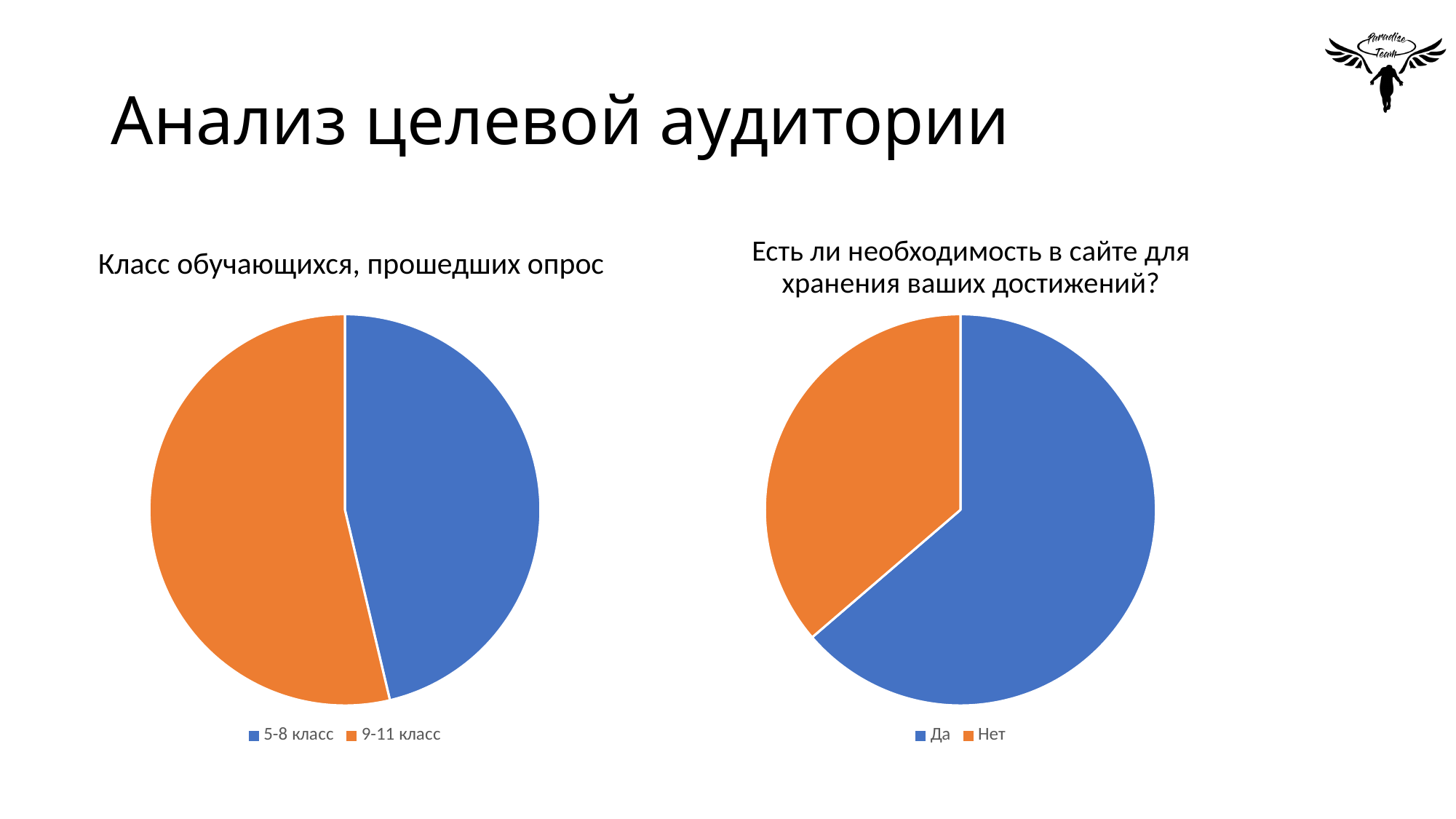
In the left chart "Класс обучающихся, прошедших опрос", what colour is the slice for 5-8 класс? blue In the left chart "Класс обучающихся, прошедших опрос", which category has the largest slice? 9-11 класс What kind of chart is the right chart titled "Есть ли необходимость в сайте для хранения ваших достижений?"? pie chart In the left chart "Класс обучающихся, прошедших опрос", which category has the smallest slice? 5-8 класс In the left chart "Класс обучающихся, прошедших опрос", which slice is larger, 5-8 класс or 9-11 класс? 9-11 класс In the right chart "Есть ли необходимость в сайте для хранения ваших достижений?", how many categories does the legend list? 2 What kind of chart is the left chart titled "Класс обучающихся, прошедших опрос"? pie chart What are the two legend entries of the right chart "Есть ли необходимость в сайте для хранения ваших достижений?"? Да, Нет In the right chart "Есть ли необходимость в сайте для хранения ваших достижений?", which slice is larger, Да or Нет? Да In the right chart "Есть ли необходимость в сайте для хранения ваших достижений?", which answer has the largest slice? Да In the right chart "Есть ли необходимость в сайте для хранения ваших достижений?", which answer has the smallest slice? Нет In the left chart "Класс обучающихся, прошедших опрос", how many slices does the pie have? 2